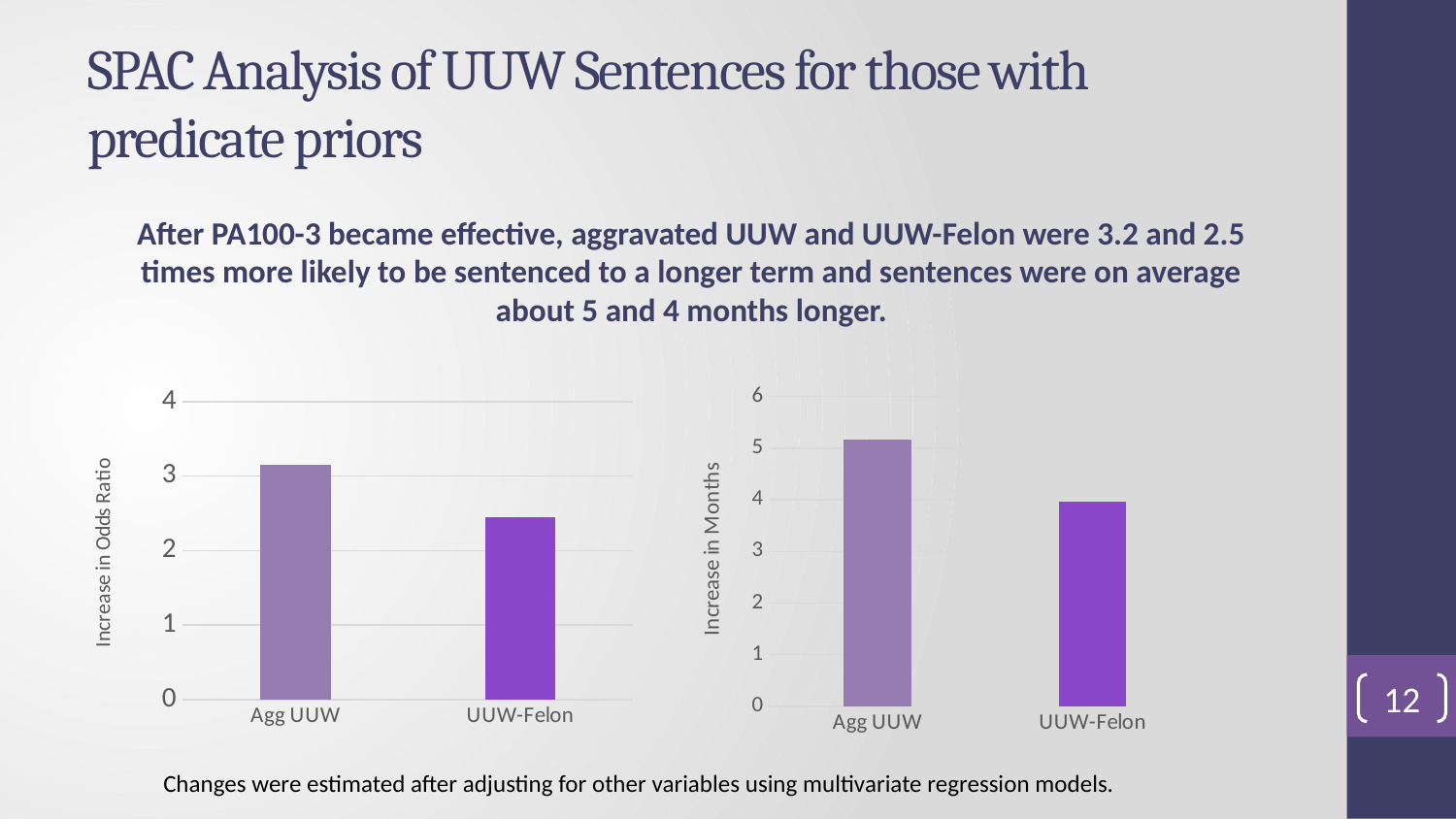
In the right chart (Increase in Months), is the value for Agg UUW greater or less than 5? greater In the left chart (Increase in Odds Ratio), which category has the highest value? Agg UUW In the left chart (Increase in Odds Ratio), is the value for UUW-Felon greater or less than 3? less In the right chart (Increase in Months), is the value for UUW-Felon greater or less than 3? greater In the right chart (Increase in Months), which category has the highest value? Agg UUW In the left chart (Increase in Odds Ratio), which category has the lowest value? UUW-Felon What kind of chart is the right chart (Increase in Months)? bar chart In the right chart (Increase in Months), which category has the lowest value? UUW-Felon What kind of chart is the left chart (Increase in Odds Ratio)? bar chart How many categories are shown in the left chart (Increase in Odds Ratio)? 2 What is the y-axis label of the right chart? Increase in Months